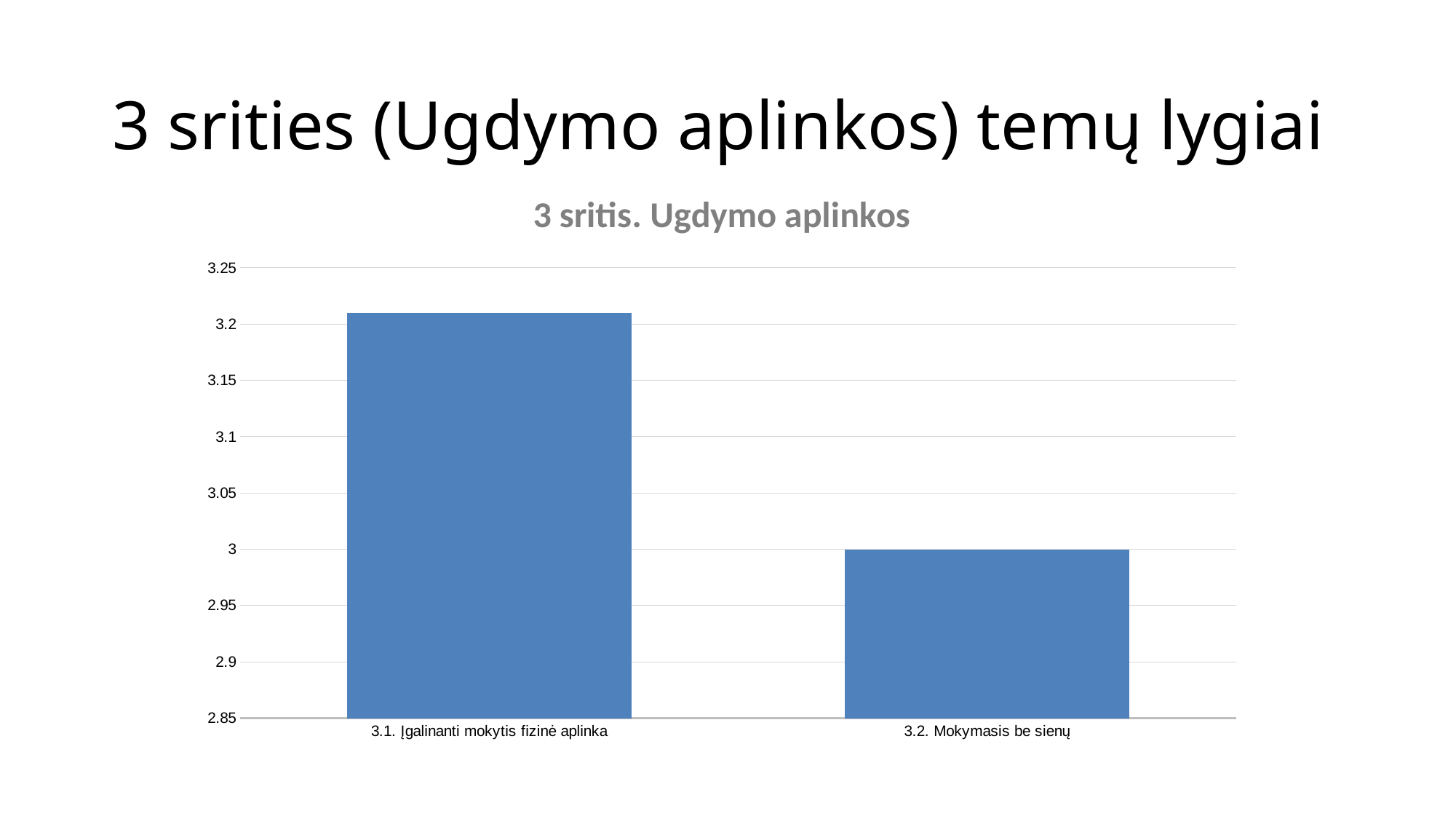
How many categories are plotted in the chart? 2 What is the title of the chart? 3 sritis. Ugdymo aplinkos Which category has the lowest value? 3.2. Mokymasis be sienų Is the value for 3.1. Įgalinanti mokytis fizinė aplinka greater or less than 3.1? greater Which category has the highest value? 3.1. Įgalinanti mokytis fizinė aplinka Is the value for 3.1. Įgalinanti mokytis fizinė aplinka greater or less than 3.15? greater What kind of chart is shown on the slide? bar chart Which is larger, the value for 3.1. Įgalinanti mokytis fizinė aplinka or the value for 3.2. Mokymasis be sienų? 3.1. Įgalinanti mokytis fizinė aplinka What is the value for 3.2. Mokymasis be sienų? 3 Is the value for 3.2. Mokymasis be sienų greater or less than 3.05? less What is the lowest value shown on the vertical axis of the chart? 2.85